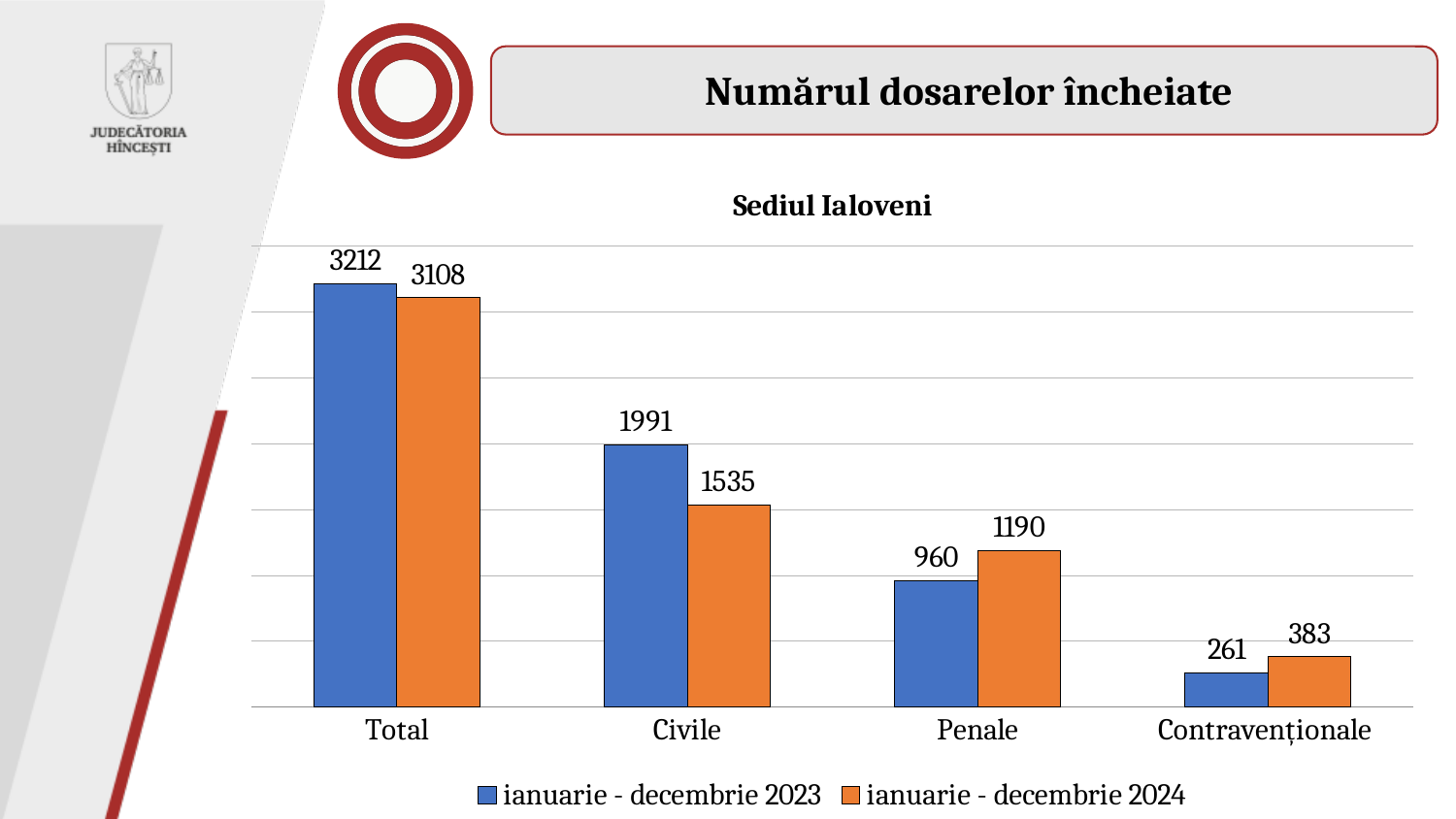
Which category has the lowest value in the ianuarie - decembrie 2024 series? Contravenționale What is the value for Civile in the ianuarie - decembrie 2023 series? 1991 How many categories are shown on the x axis? 4 What is the value for Contravenționale in the ianuarie - decembrie 2023 series? 261 What is the difference between the 2023 and 2024 values for Civile? 456 What is the difference between the 2024 and 2023 values for Penale? 230 How many series does the legend list? 2 What is the Total value for ianuarie - decembrie 2024? 3108 What is the value for Penale in the ianuarie - decembrie 2024 series? 1190 Excluding Total, which category has the highest value in the ianuarie - decembrie 2023 series? Civile Which is larger for Contravenționale: the 2023 value or the 2024 value? the 2024 value (383) What type of chart is shown on the slide? bar chart